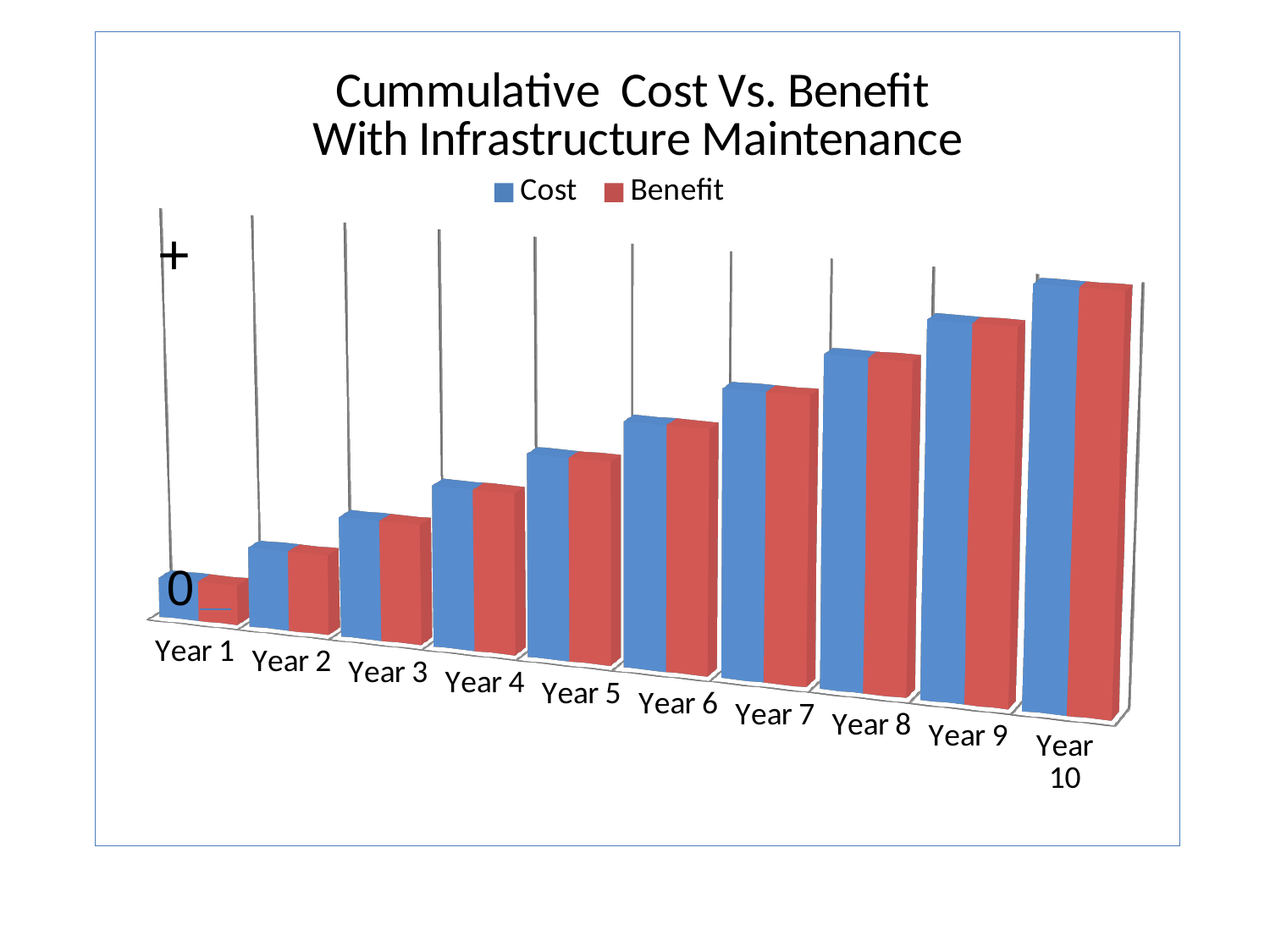
How many series does the legend list? 2 What kind of chart is shown on the slide? bar chart Which colour represents the Benefit series in the legend? red Do the Cost values rise or fall from Year 1 to Year 10? rise How many year categories are shown on the x axis? 10 Which year has the lowest Benefit bar? Year 1 Which year has the highest Benefit bar? Year 10 Which year has the highest Cost bar? Year 10 What is the title of the chart? Cummulative Cost Vs. Benefit With Infrastructure Maintenance Which is larger, the Cost bar for Year 10 or the Cost bar for Year 2? Year 10 Do the Benefit values rise or fall from Year 1 to Year 10? rise Which year has the lowest Cost bar? Year 1